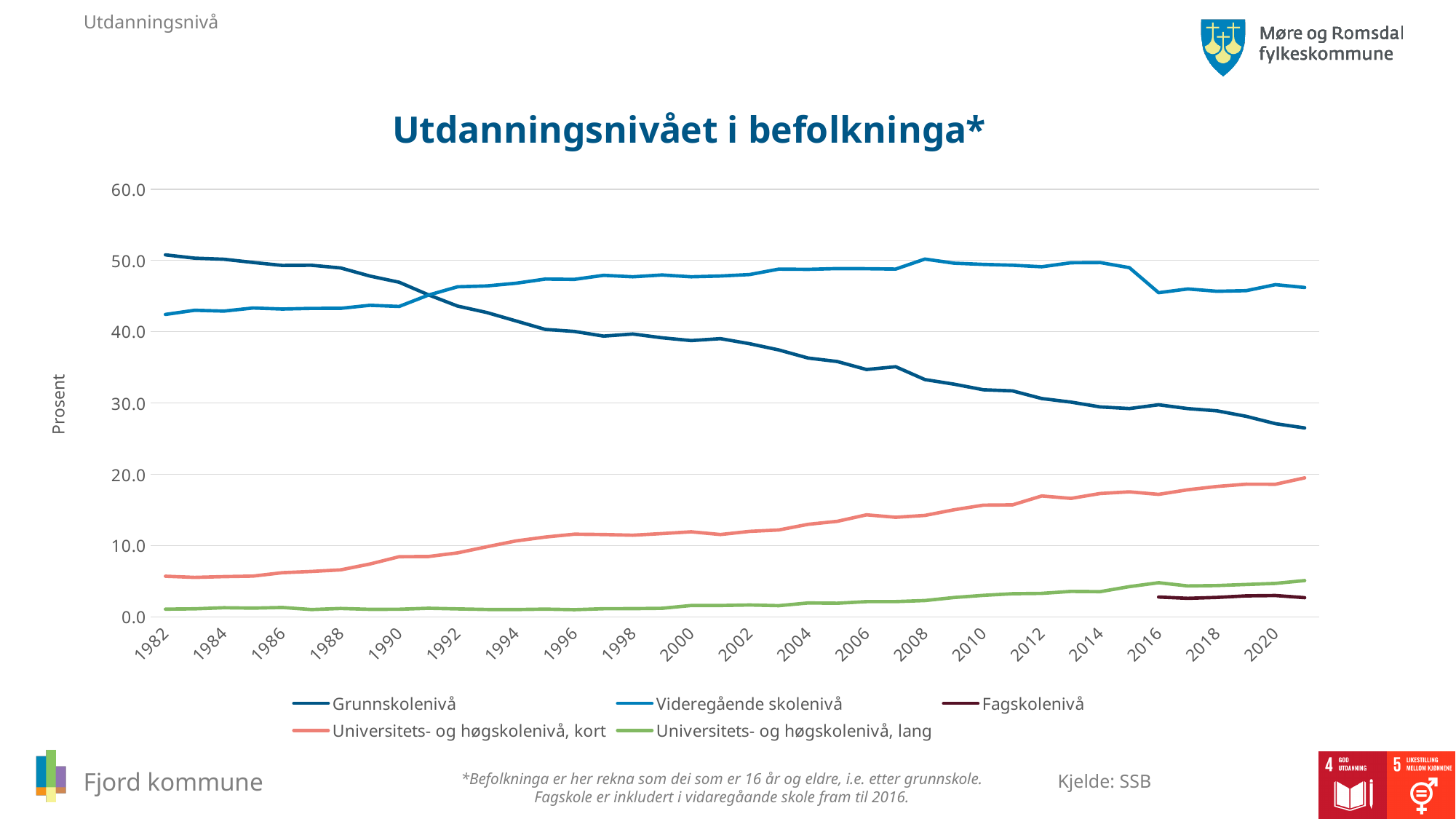
Is the value for Grunnskolenivå in 2020 greater or less than 30.0? less In 1982, which is larger: Grunnskolenivå or Videregående skolenivå? Grunnskolenivå What kind of chart is shown on the slide? line chart Is the value for Videregående skolenivå in 1982 greater or less than 40.0? greater How many series does the legend list? 5 Does the value for Universitets- og høgskolenivå, kort rise or fall from 1982 to 2020? rise Is the value for Universitets- og høgskolenivå, lang in 2020 greater or less than 10.0? less What is the label on the vertical axis? Prosent Does the value for Grunnskolenivå rise or fall from 1982 to 2020? fall Which series has the highest value in 2020? Videregående skolenivå Which series has the lowest value in 2020? Fagskolenivå